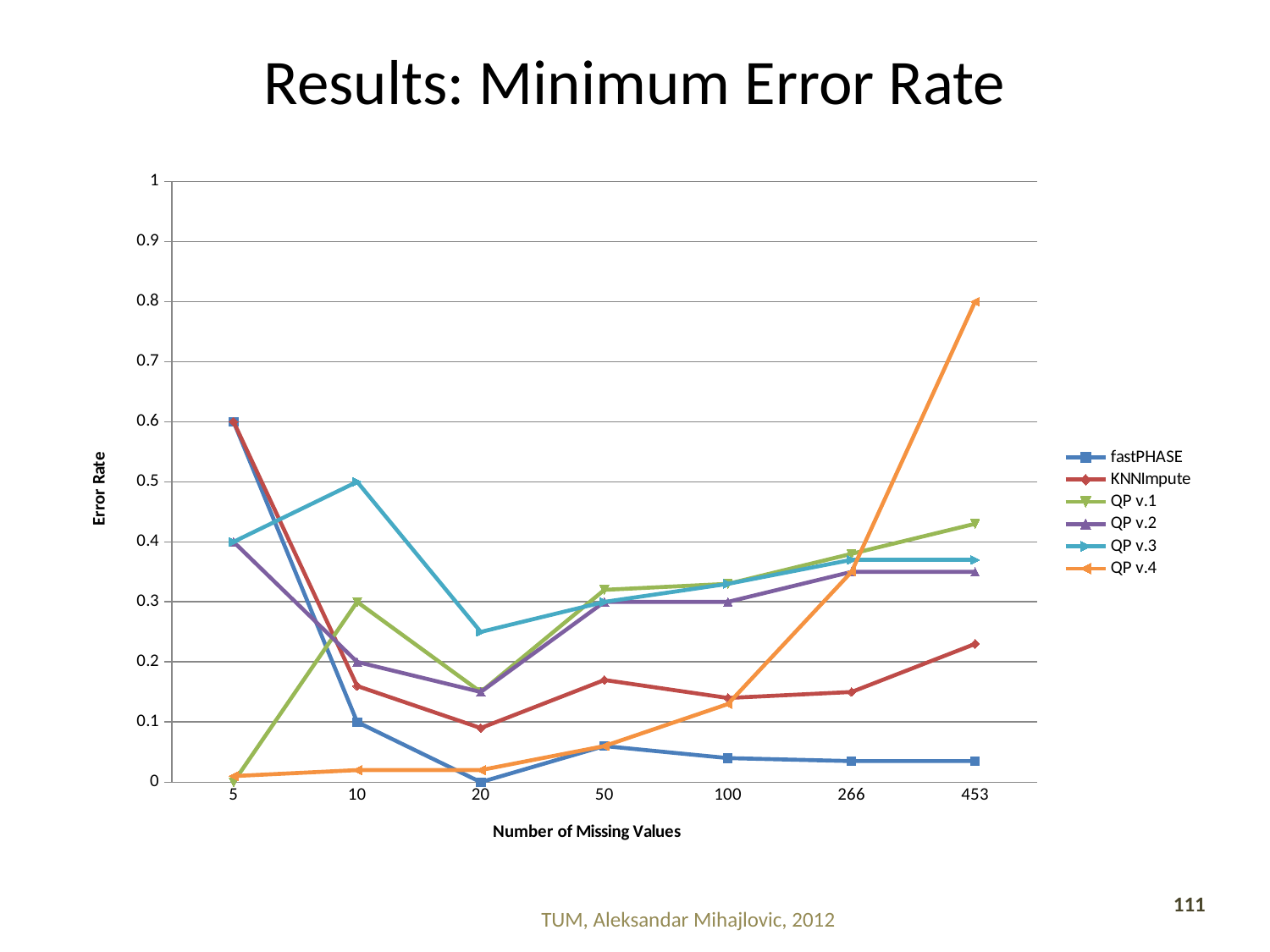
Which series has the highest error rate at 453 missing values? QP v.4 What is the error rate for fastPHASE at 20 missing values? 0 What is the error rate for QP v.3 at 10 missing values? 0.5 What is the error rate for QP v.4 at 453 missing values? 0.8 Does the error rate for QP v.4 rise or fall from 100 to 453 missing values? rise What kind of chart is shown on the slide? line chart Which series has the lowest error rate at 453 missing values? fastPHASE At 266 missing values, which has the higher error rate, QP v.4 or KNNImpute? QP v.4 Is the error rate for fastPHASE at 453 missing values greater or less than 0.1? less Is the error rate for KNNImpute at 453 missing values greater or less than 0.2? greater How many values of Number of Missing Values are plotted along the x axis? 7 How many series does the legend list? 6